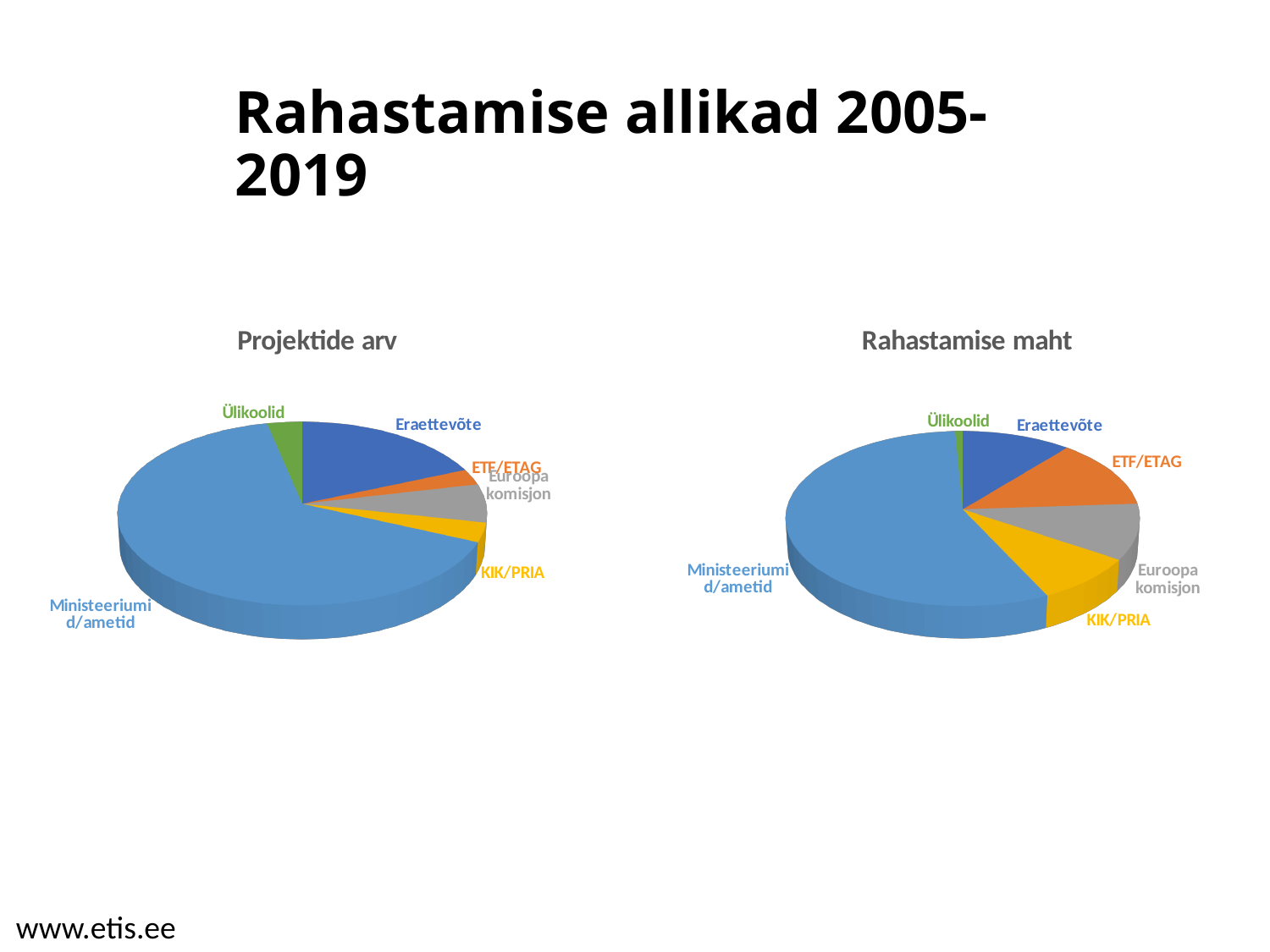
In the "Projektide arv" chart, which category has the smallest slice? ETF/ETAG In the "Projektide arv" chart, which slice is larger: Eraettevõte or ETF/ETAG? Eraettevõte In the "Rahastamise maht" chart, which category has the smallest slice? Ülikoolid In the "Rahastamise maht" chart, which slice is larger: KIK/PRIA or Ülikoolid? KIK/PRIA In the "Rahastamise maht" chart, which category has the largest slice? Ministeeriumid/ametid What is the title of the chart on the left? Projektide arv In the "Rahastamise maht" chart, how many categories (slices) are shown? 6 What is the title of the chart on the right? Rahastamise maht What kind of chart is the "Projektide arv" chart on the left? Pie chart What kind of chart is the "Rahastamise maht" chart on the right? Pie chart In the "Projektide arv" chart, which category has the largest slice? Ministeeriumid/ametid In the "Projektide arv" chart, how many categories (slices) are shown? 6